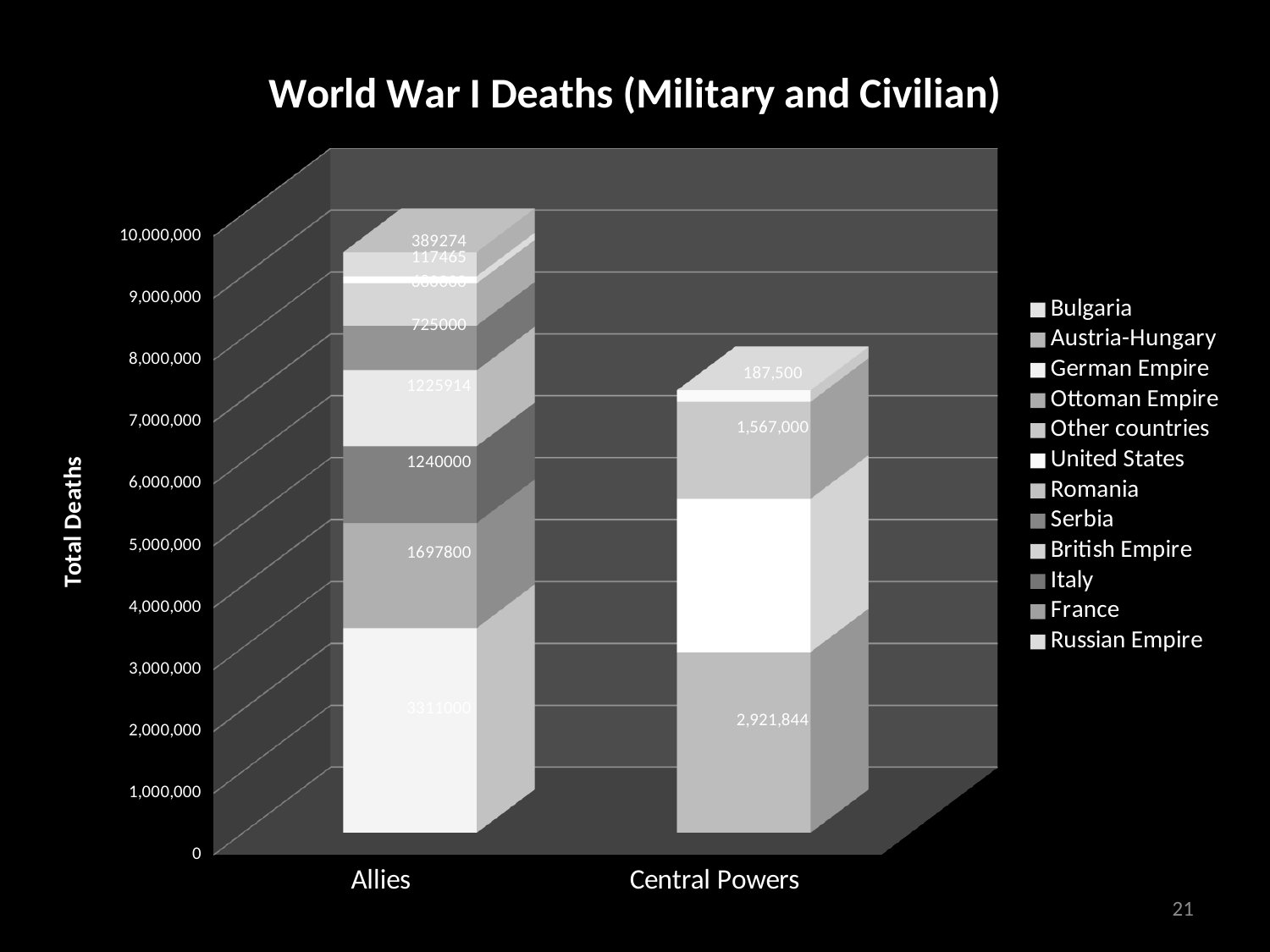
How many categories are shown on the x axis of the chart? 2 What value is labelled on the top segment of the Central Powers bar? 187,500 How many series does the chart's legend list? 12 What is the title of the chart? World War I Deaths (Military and Civilian) What is the smallest labelled value in the Central Powers bar? 187,500 Is the total height of the Central Powers bar greater or less than 8,000,000? less What is the largest labelled value in the Allies bar? 3311000 What is the label on the vertical axis of the chart? Total Deaths What value is labelled on the bottom segment of the Central Powers bar? 2,921,844 What value is labelled on the bottom segment of the Allies bar? 3311000 What kind of chart is shown on the slide? Stacked bar chart Which category has the taller stacked bar, Allies or Central Powers? Allies